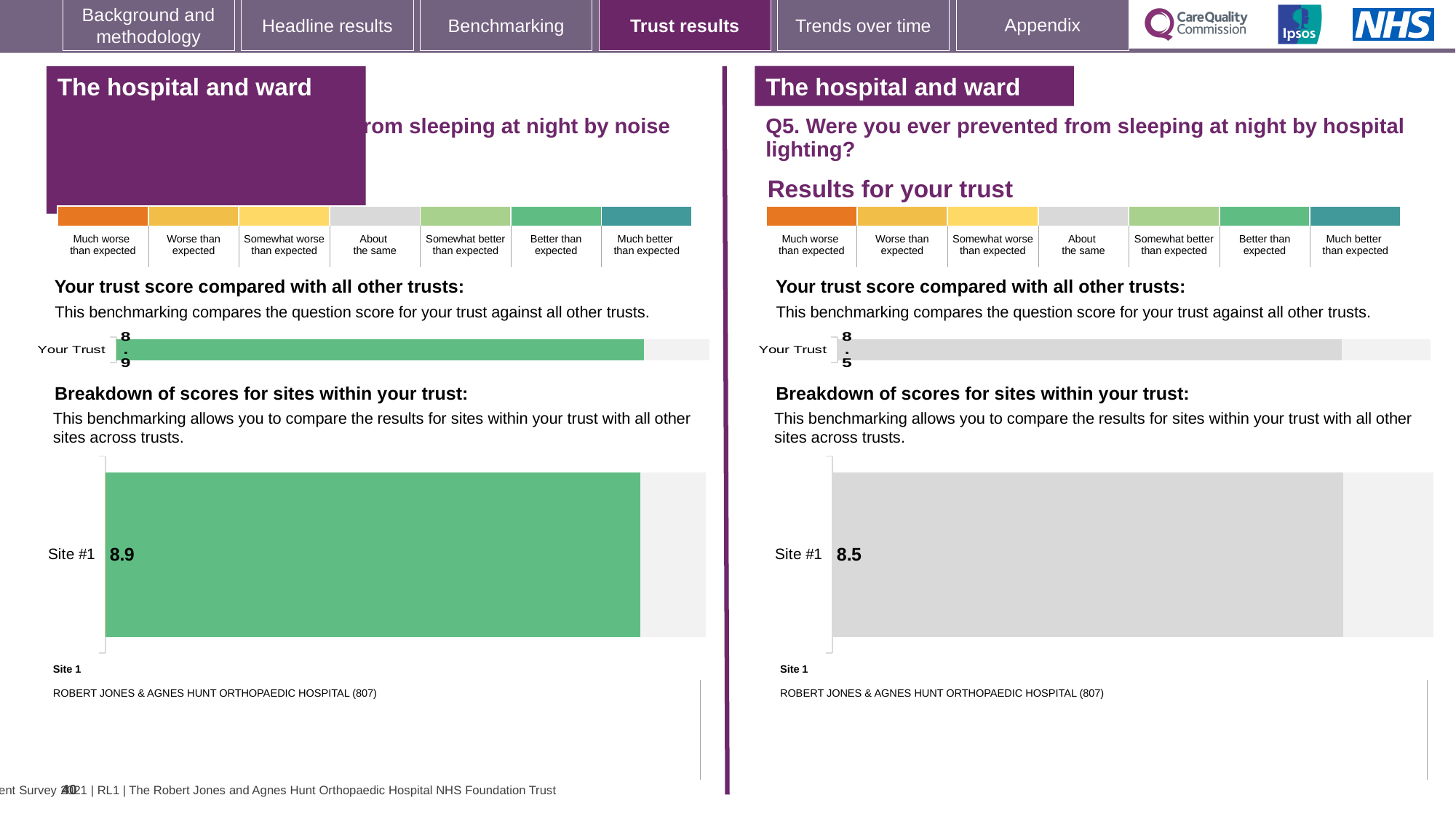
On the right-hand side (Q5, hospital lighting), what is the score shown for Site #1 in the 'Breakdown of scores for sites within your trust' chart? 8.5 What is the difference between the Site #1 score on the left-hand (noise) chart and the Site #1 score on the right-hand (Q5, hospital lighting) chart? 0.4 On the left-hand side (the question about noise), what is the score shown for Site #1 in the 'Breakdown of scores for sites within your trust' chart? 8.9 On the right-hand side (Q5, hospital lighting), which site name is listed as Site 1 below the chart? ROBERT JONES & AGNES HUNT ORTHOPAEDIC HOSPITAL (807) On the right-hand side (Q5, hospital lighting), what colour is the Site #1 bar? Grey On the left-hand side (the question about noise), what is the score shown for Your Trust in the 'Your trust score compared with all other trusts' chart? 8.9 On the left-hand side (noise question), what colour is the Your Trust bar? Green How many sites are shown in the 'Breakdown of scores for sites within your trust' chart on the right-hand side (Q5, hospital lighting)? 1 What kind of chart is used to show the Site #1 score on the right-hand side (Q5, hospital lighting)? Bar chart How many sites are shown in the 'Breakdown of scores for sites within your trust' chart on the left-hand side (noise question)? 1 On the right-hand side (Q5, hospital lighting), what is the score shown for Your Trust in the 'Your trust score compared with all other trusts' chart? 8.5 Which is larger: the Site #1 score on the left-hand (noise) chart or the Site #1 score on the right-hand (Q5, hospital lighting) chart? Left-hand (noise) chart, 8.9